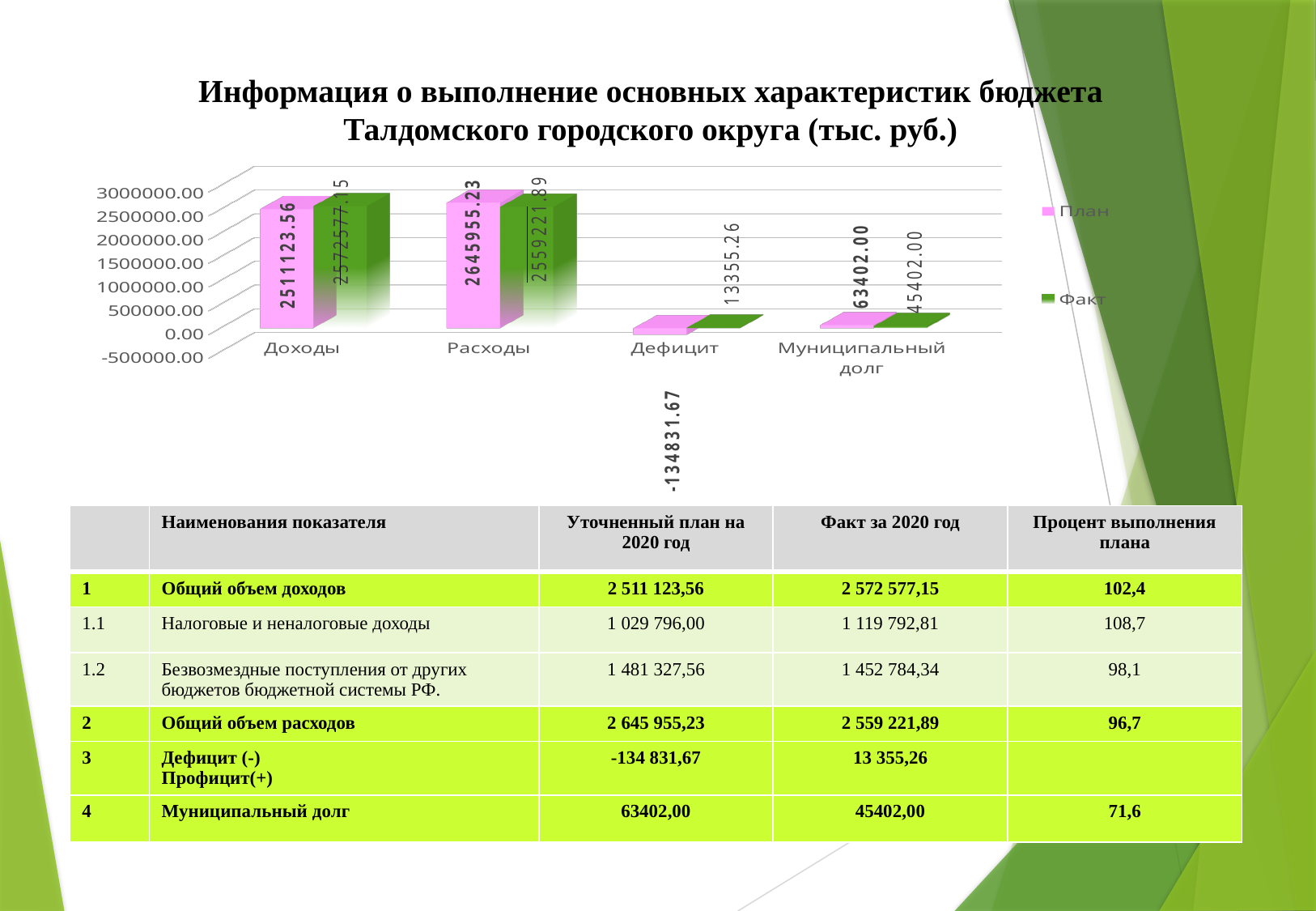
Which category has the lowest Факт value? Дефицит How many categories are shown on the x axis of the chart? 4 What is the Факт value for Муниципальный долг? 45402.00 Which category has the highest План value? Расходы What is the План value for Доходы? 2511123.56 What is the difference between the План and Факт values for Муниципальный долг? 18000.00 Is the Факт value for Расходы greater or less than 2000000.00? greater How many series does the chart legend list? 2 What is the Факт value for Расходы? 2559221.89 What kind of chart is shown on the slide? bar chart What is the План value for Дефицит? -134831.67 For Доходы, which is larger: the План value or the Факт value? Факт